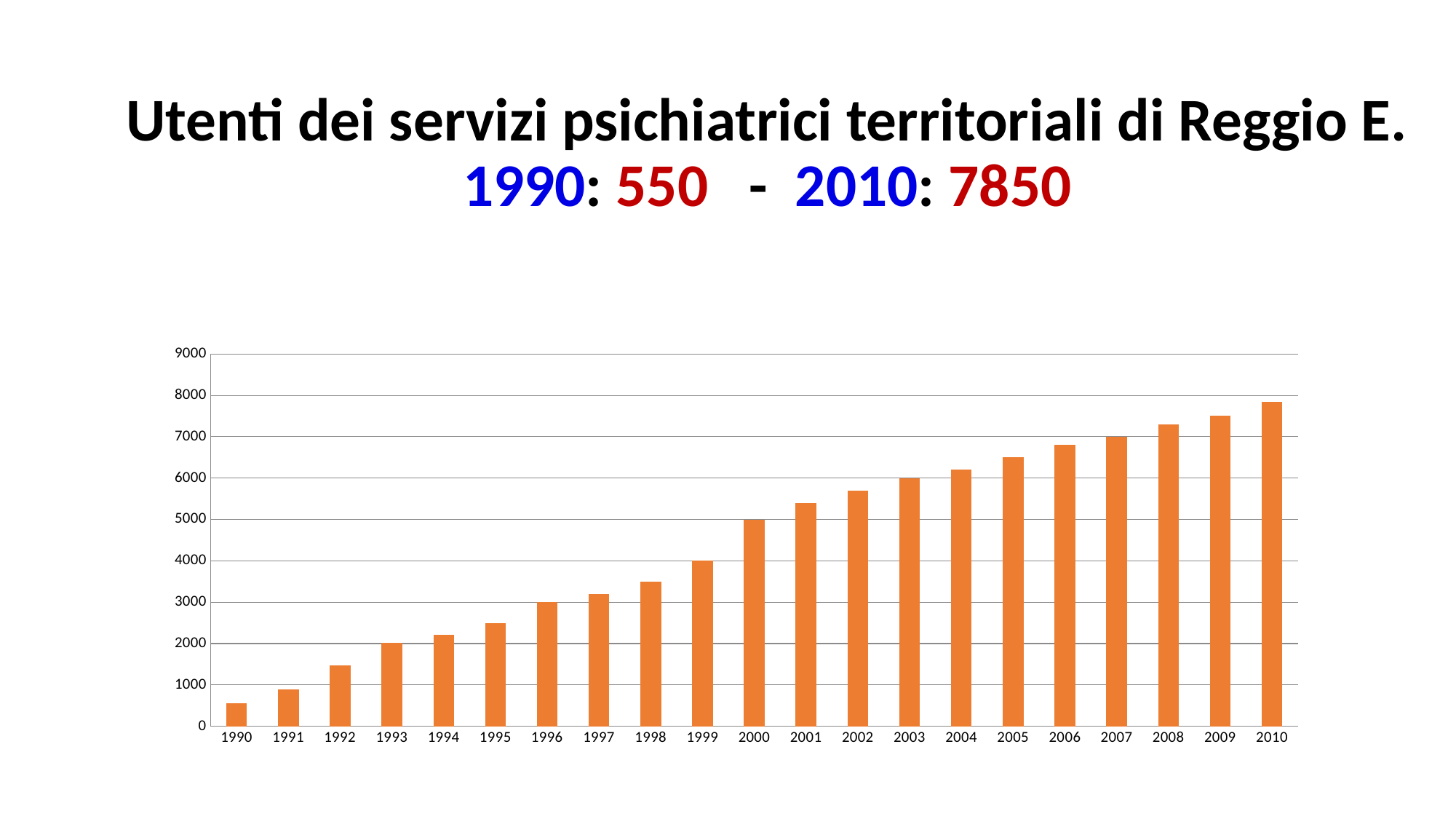
Do the values rise or fall from 1990 to 2010? rise What kind of chart is shown on the slide? bar chart What is the title of the chart on the slide? Utenti dei servizi psichiatrici territoriali di Reggio E. Is the value for 1995 greater or less than 3000? less What is the difference between the value for 2010 and the value for 1990? 7300 Which is larger, the value for 1998 or the value for 2001? 2001 Which year has the lowest value in the chart? 1990 What is the value for 2010 according to the slide? 7850 How many years are plotted on the x axis of the chart? 21 Which year has the highest value in the chart? 2010 What is the value for 1990 according to the slide? 550 Is the value for 2005 greater or less than 6000? greater